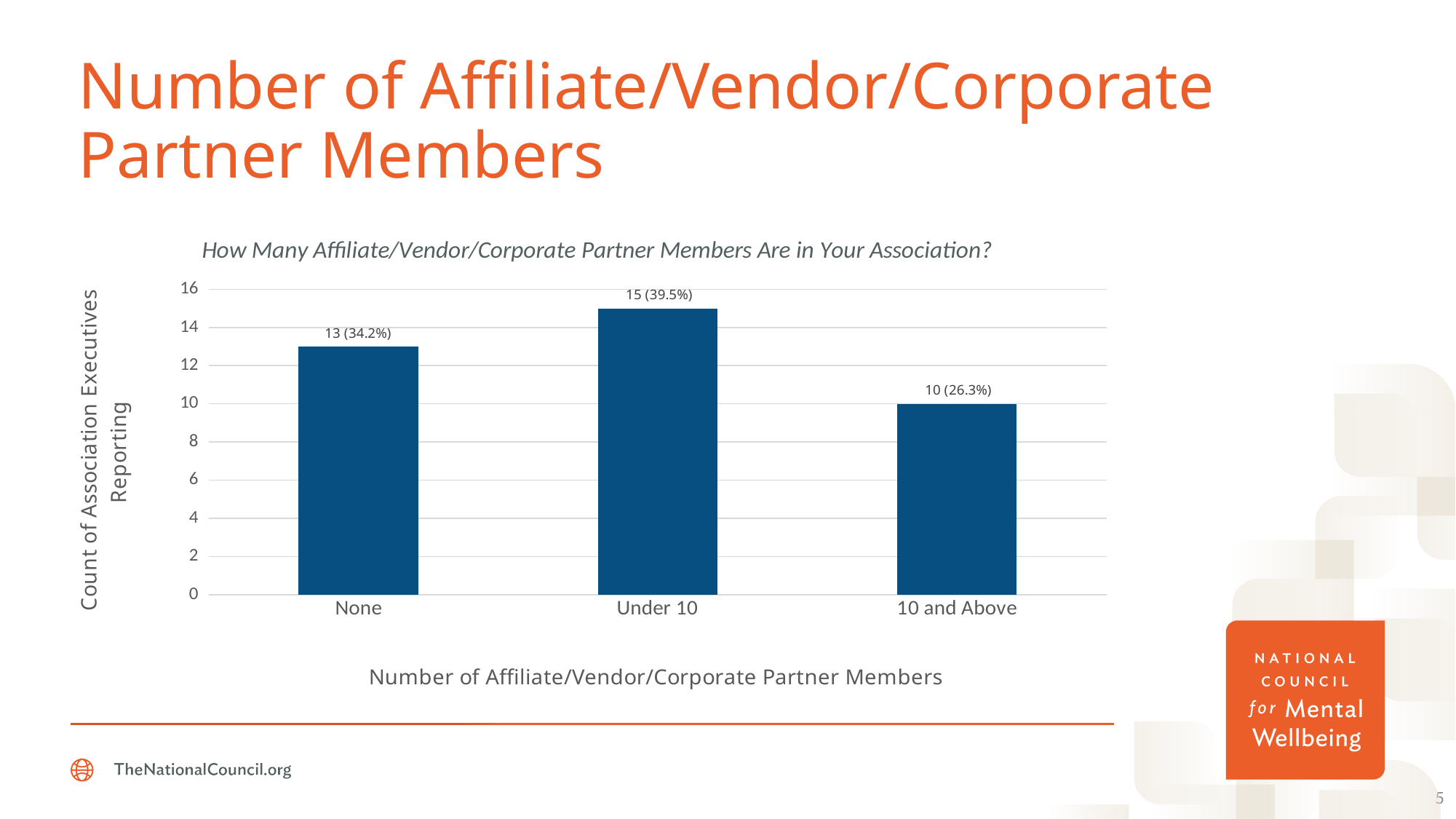
What is the title of the chart? How Many Affiliate/Vendor/Corporate Partner Members Are in Your Association? Which has a larger count: 'None' or '10 and Above'? None What is the count of association executives reporting 'Under 10' affiliate/vendor/corporate partner members? 15 (39.5%) What is the count of association executives reporting 'None' affiliate/vendor/corporate partner members? 13 (34.2%) What kind of chart is shown on the slide? Bar chart Is the count for 'Under 10' greater or less than 14? greater What is the difference in count between the 'Under 10' and 'None' categories? 2 Which category has the lowest count of association executives reporting? 10 and Above What is the difference in count between the 'None' and '10 and Above' categories? 3 Which category has the highest count of association executives reporting? Under 10 How many categories are shown on the x axis of the chart? 3 What is the count of association executives reporting '10 and Above' affiliate/vendor/corporate partner members? 10 (26.3%)